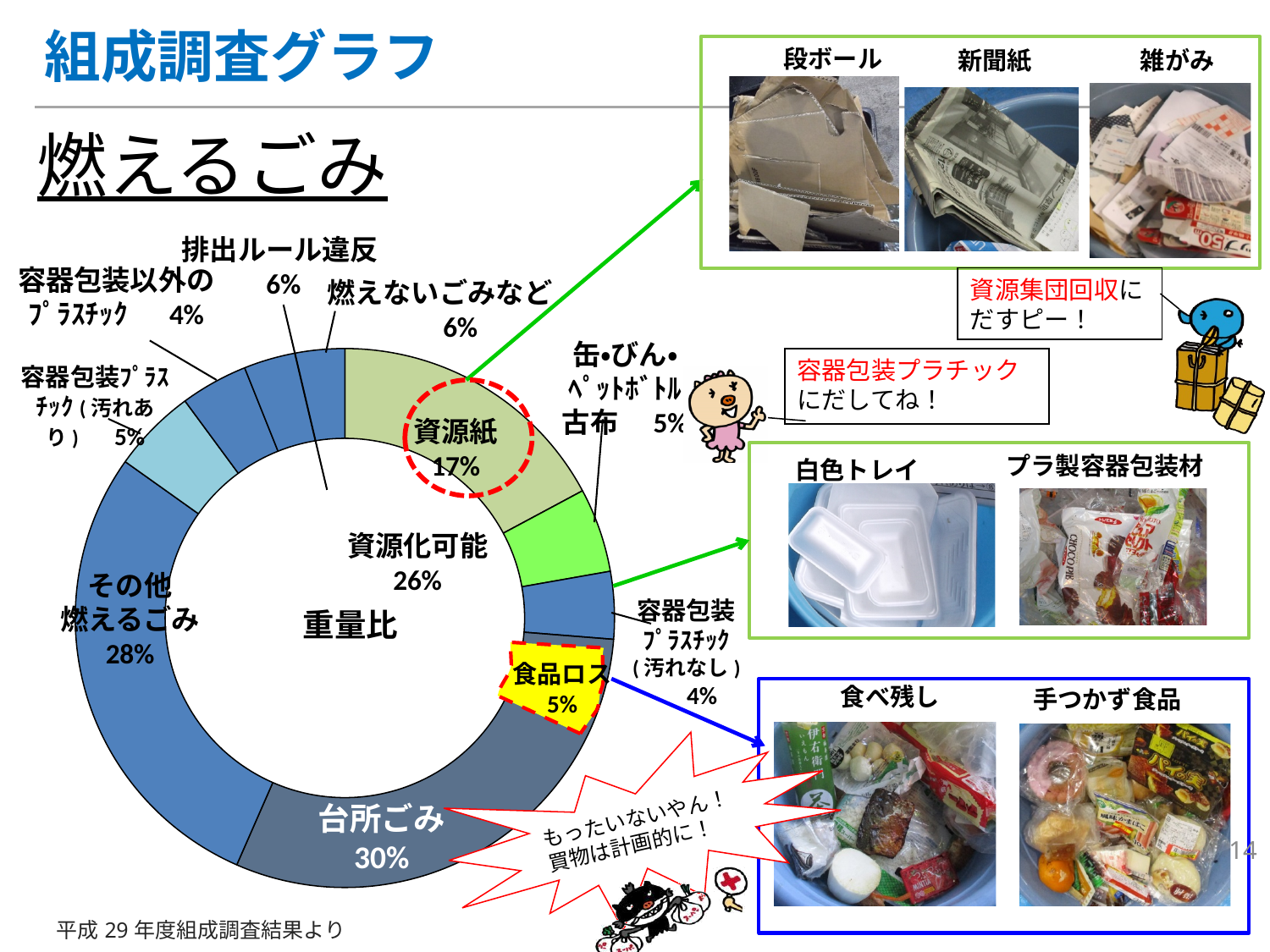
What percentage is shown for 食品ロス? 5% What percentage does 台所ごみ account for in the chart? 30% What label appears in the centre of the donut chart indicating the basis of the proportions? 重量比 What percentage does その他燃えるごみ account for? 28% What percentage is labelled as 資源化可能 inside the chart? 26% What percentage is shown for 排出ルール違反? 6% What kind of chart is shown on the slide? pie chart (donut) Which is larger, 資源紙 or 燃えないごみなど? 資源紙 What is the difference in percentage points between 台所ごみ and その他燃えるごみ? 2 Which category has the largest share in the chart? 台所ごみ What is the difference in percentage points between 資源紙 and 食品ロス? 12 What is the share of 資源紙 in the chart? 17%